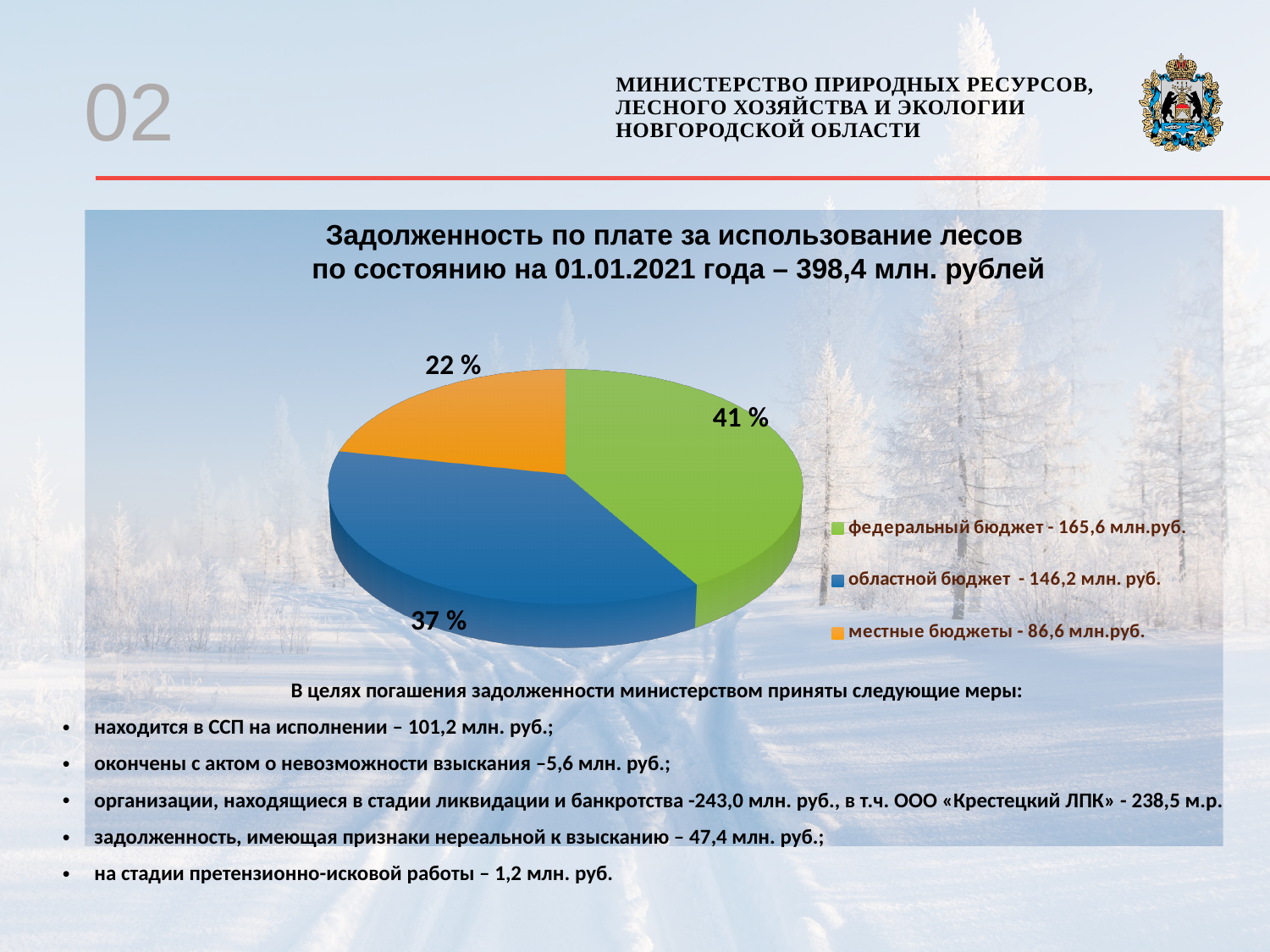
What share of the pie does the regional budget (областной бюджет) slice represent? 37 % According to the legend, what is the debt amount for the local budgets (местные бюджеты)? 86,6 млн.руб. What share of the pie does the federal budget (федеральный бюджет) slice represent? 41 % Which budget category has the largest slice of the pie? федеральный бюджет What share of the pie does the local budgets (местные бюджеты) slice represent? 22 % Which budget category has the smallest slice of the pie? местные бюджеты What kind of chart is shown on the slide? pie chart According to the legend, what is the debt amount for the federal budget (федеральный бюджет)? 165,6 млн.руб. What colour is the slice for the regional budget (областной бюджет)? blue By how many percentage points does the federal budget share exceed the regional budget share? 4 How many entries does the legend of the pie chart list? 3 How many slices does the pie chart have? 3